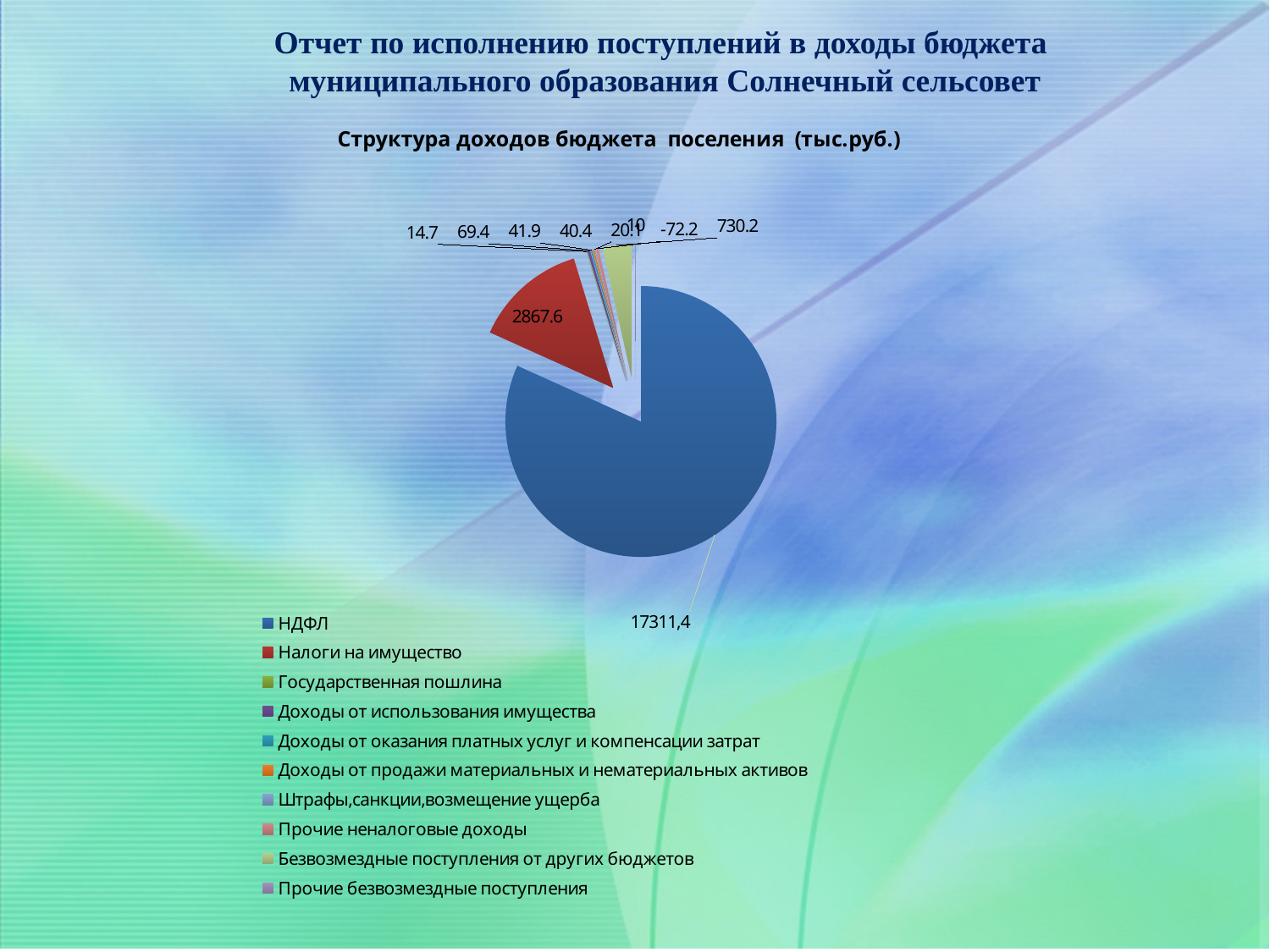
Which category has the largest slice of the pie? НДФЛ What kind of chart is shown on the slide? pie chart Is the value for Налоги на имущество greater or less than 2000? greater How many data labels are printed on the pie chart? 10 What is the value shown for НДФЛ? 17311,4 What is the value shown for Налоги на имущество? 2867.6 Which is larger, НДФЛ or Налоги на имущество? НДФЛ In what units are the chart values given, according to the chart title? тыс.руб. What is the title of the chart? Структура доходов бюджета поселения (тыс.руб.) What is the smallest data label value printed on the chart? -72.2 What is the largest data label value printed on the chart? 17311,4 How many entries does the chart legend list? 10